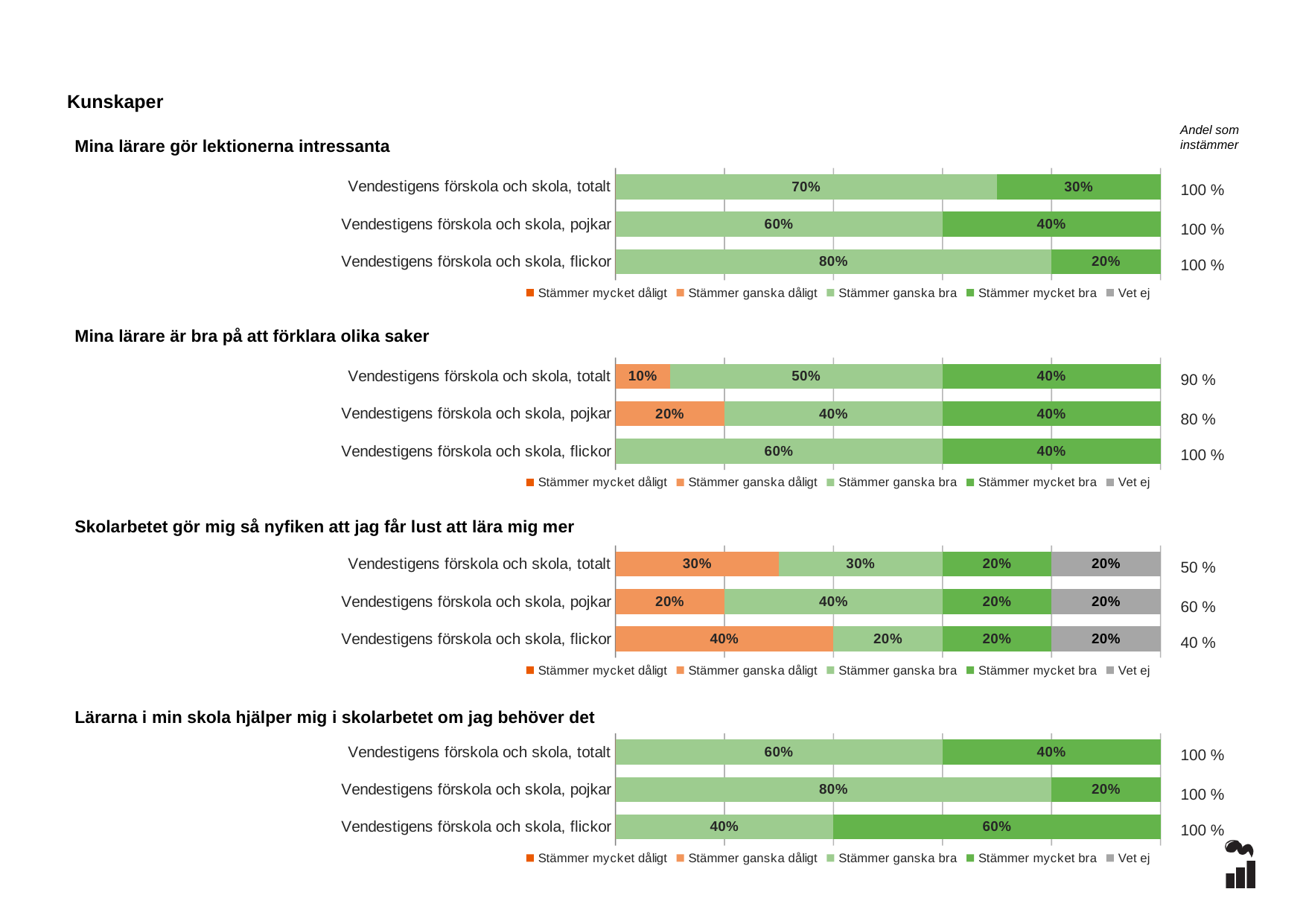
In the chart 'Mina lärare gör lektionerna intressanta', what is the 'Stämmer ganska bra' value for 'Vendestigens förskola och skola, flickor'? 80% In the chart 'Skolarbetet gör mig så nyfiken att jag får lust att lära mig mer', which category has the lowest 'Andel som instämmer' value? Vendestigens förskola och skola, flickor In the chart 'Skolarbetet gör mig så nyfiken att jag får lust att lära mig mer', what is the 'Vet ej' value for 'Vendestigens förskola och skola, totalt'? 20% In the chart 'Mina lärare gör lektionerna intressanta', what is the 'Stämmer mycket bra' value for 'Vendestigens förskola och skola, pojkar'? 40% In the chart 'Skolarbetet gör mig så nyfiken att jag får lust att lära mig mer', which category has the highest 'Stämmer ganska dåligt' value? Vendestigens förskola och skola, flickor What kind of chart is 'Skolarbetet gör mig så nyfiken att jag får lust att lära mig mer'? Stacked bar chart How many series does the legend of the chart 'Mina lärare är bra på att förklara olika saker' list? 5 In the chart 'Lärarna i min skola hjälper mig i skolarbetet om jag behöver det', which is larger: the 'Stämmer ganska bra' value for 'Vendestigens förskola och skola, totalt' or for 'Vendestigens förskola och skola, flickor'? Vendestigens förskola och skola, totalt How many categories does the chart 'Mina lärare gör lektionerna intressanta' show? 3 In the chart 'Mina lärare är bra på att förklara olika saker', what is the 'Stämmer ganska dåligt' value for 'Vendestigens förskola och skola, pojkar'? 20% In the chart 'Mina lärare är bra på att förklara olika saker', what is the 'Andel som instämmer' value for 'Vendestigens förskola och skola, totalt'? 90 % In the chart 'Lärarna i min skola hjälper mig i skolarbetet om jag behöver det', what is the difference between the 'Stämmer mycket bra' values for 'Vendestigens förskola och skola, flickor' and 'Vendestigens förskola och skola, pojkar'? 40%